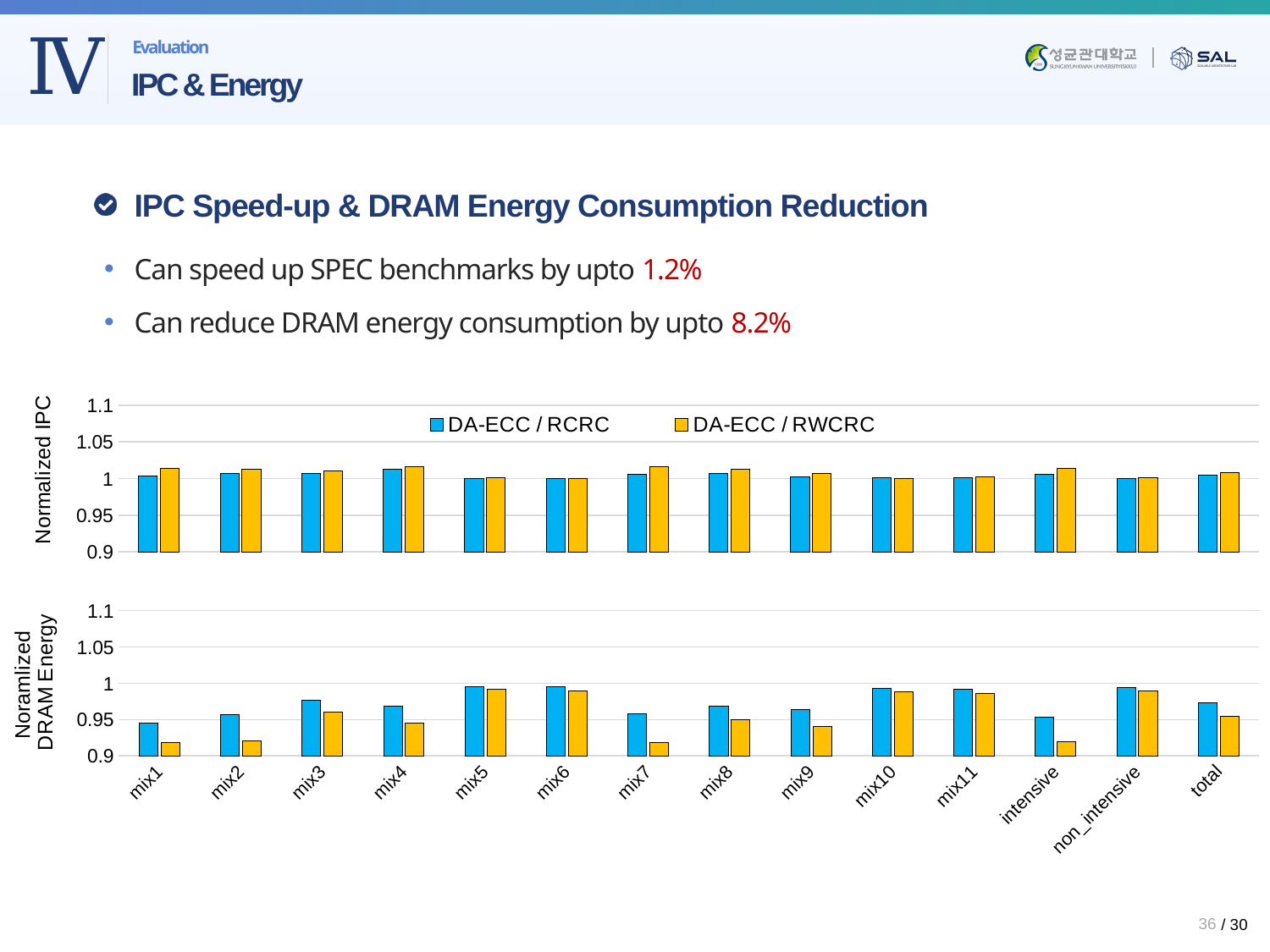
How many categories are shown along the x axis of the bottom chart (Noramlized DRAM Energy)? 14 How many series does the legend of the top chart (Normalized IPC) list? 2 In the bottom chart (Noramlized DRAM Energy), is the DA-ECC / RCRC value for mix5 greater or less than 0.95? greater In the top chart (Normalized IPC), is the DA-ECC / RCRC value for total greater or less than 1.05? less In the bottom chart (Noramlized DRAM Energy), which is larger for intensive: DA-ECC / RCRC or DA-ECC / RWCRC? DA-ECC / RCRC What kind of chart is the top chart (Normalized IPC)? bar chart What colour are the DA-ECC / RWCRC bars in the charts? yellow/orange What is the y-axis label of the top chart? Normalized IPC In the top chart (Normalized IPC), is the DA-ECC / RWCRC value for mix4 greater or less than 0.95? greater In the bottom chart (Noramlized DRAM Energy), which is larger for mix1: DA-ECC / RCRC or DA-ECC / RWCRC? DA-ECC / RCRC